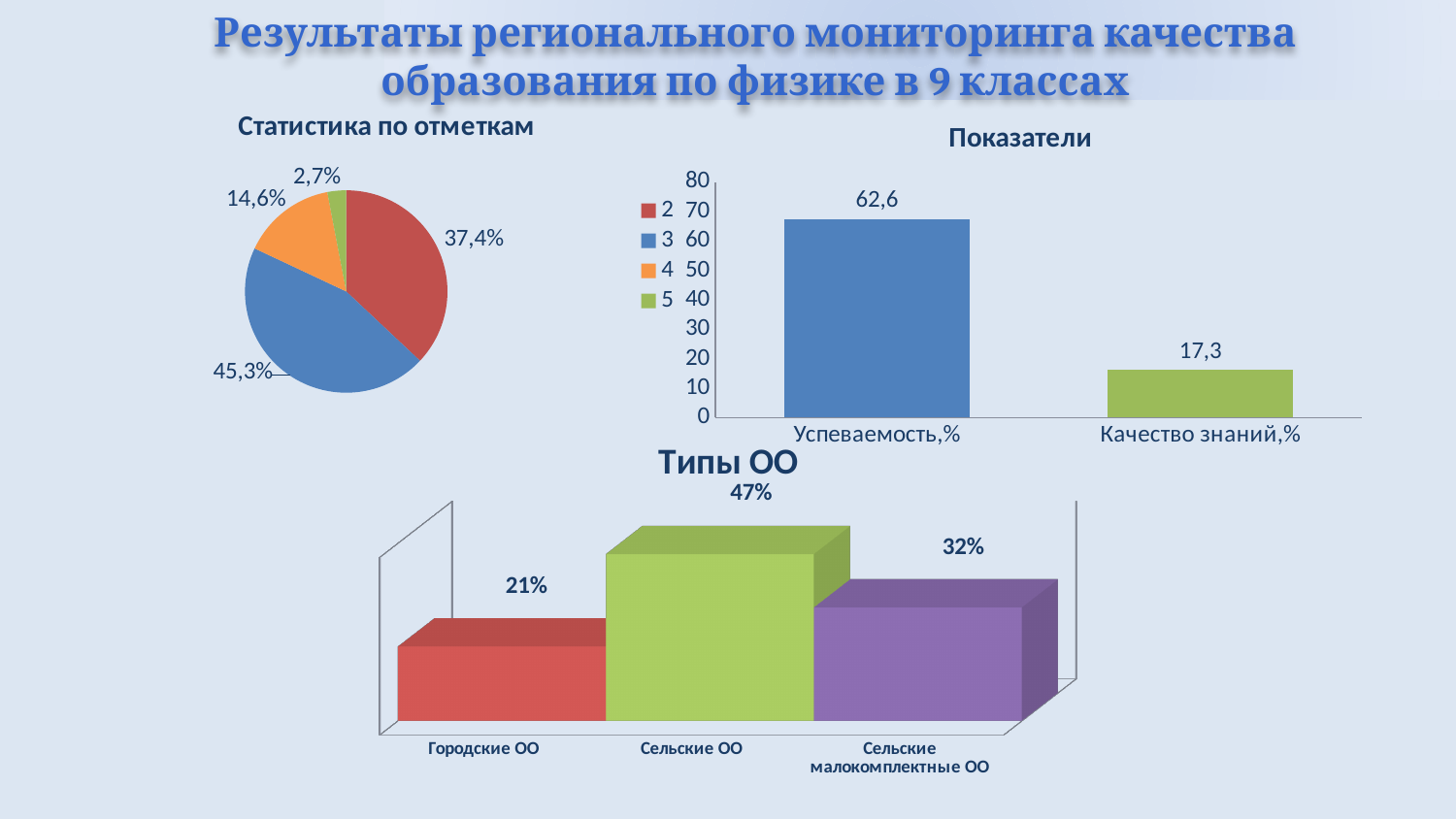
In the 'Статистика по отметкам' pie chart, what share is shown for grade 3? 45,3% In the 'Типы ОО' chart, which category has the lowest value? Городские ОО In the 'Статистика по отметкам' pie chart, which grade has the smallest slice? 5 In the 'Типы ОО' chart, what is the value for Сельские ОО? 47% In the 'Показатели' chart, what is the difference between Успеваемость,% and Качество знаний,%? 45,3 In the 'Показатели' chart, what is the value for Качество знаний,%? 17,3 What kind of chart is the 'Показатели' chart? Bar chart In the 'Типы ОО' chart, which is larger: Сельские малокомплектные ОО or Городские ОО? Сельские малокомплектные ОО In the 'Статистика по отметкам' pie chart, what share is shown for grade 5? 2,7% In the 'Показатели' chart, what is the value for Успеваемость,%? 62,6 In the 'Статистика по отметкам' pie chart, which grade has the largest slice? 3 In the 'Статистика по отметкам' pie chart, how many slices are there? 4